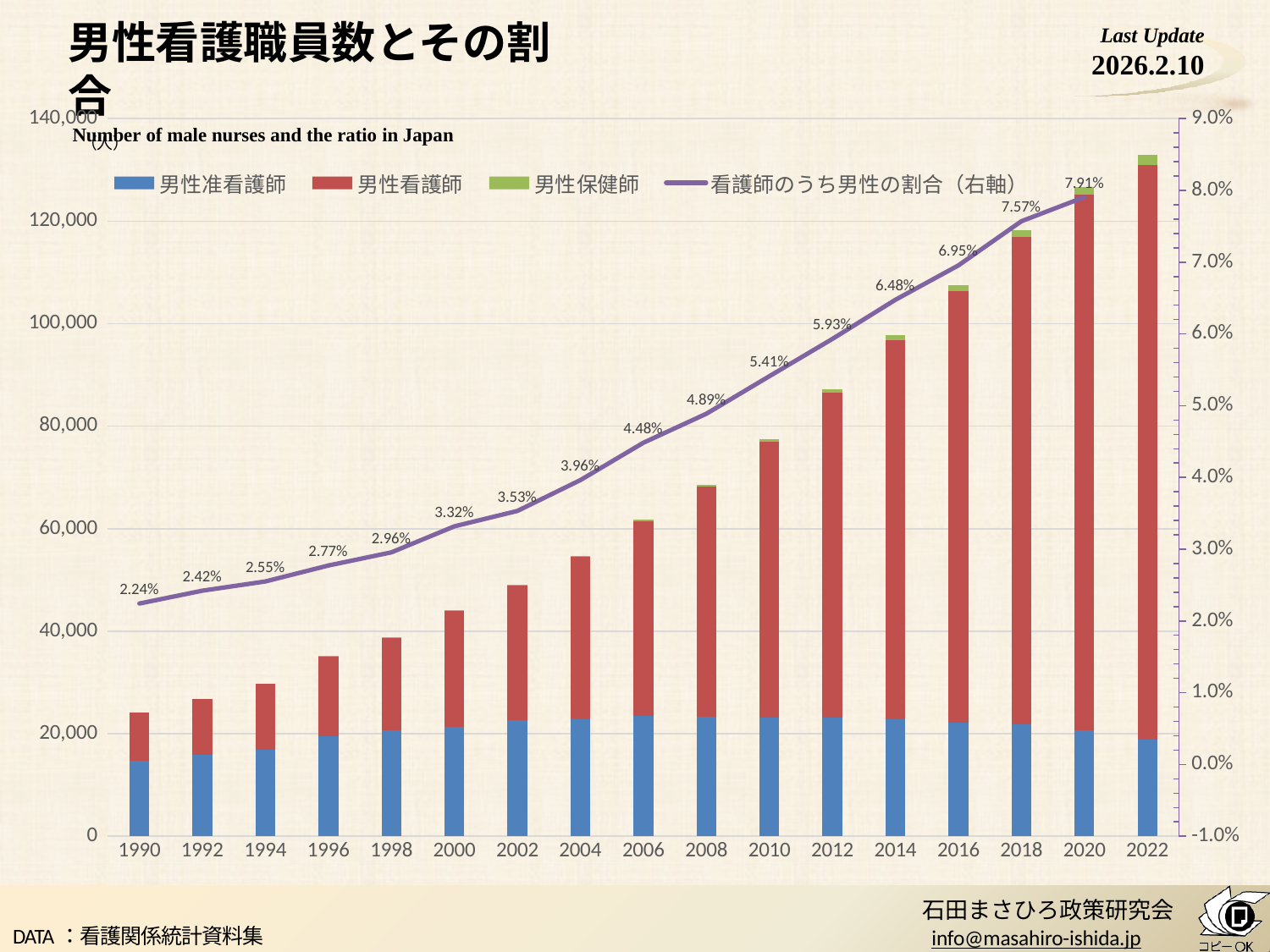
Is the total number of male nursing staff in 2022 greater or less than 120,000? greater In which year is the labelled male nurse ratio lowest? 1990 What kind of chart is this? Stacked bar chart combined with a line chart What is the ratio of male nurses shown for 1990? 2.24% What is the ratio of male nurses shown for 2020? 7.91% What is the ratio of male nurses (看護師のうち男性の割合) shown for 2010? 5.41% What is the difference between the male nurse ratio in 2000 and in 1998? 0.36 percentage points How many years are shown on the x axis? 17 How many series does the legend list? 4 By how many percentage points did the male nurse ratio increase from 1990 to 2020? 5.67 percentage points Is the total number of male nursing staff in 2010 greater or less than 80,000? less Does the male nurse ratio line rise or fall from 1990 to 2020? Rises